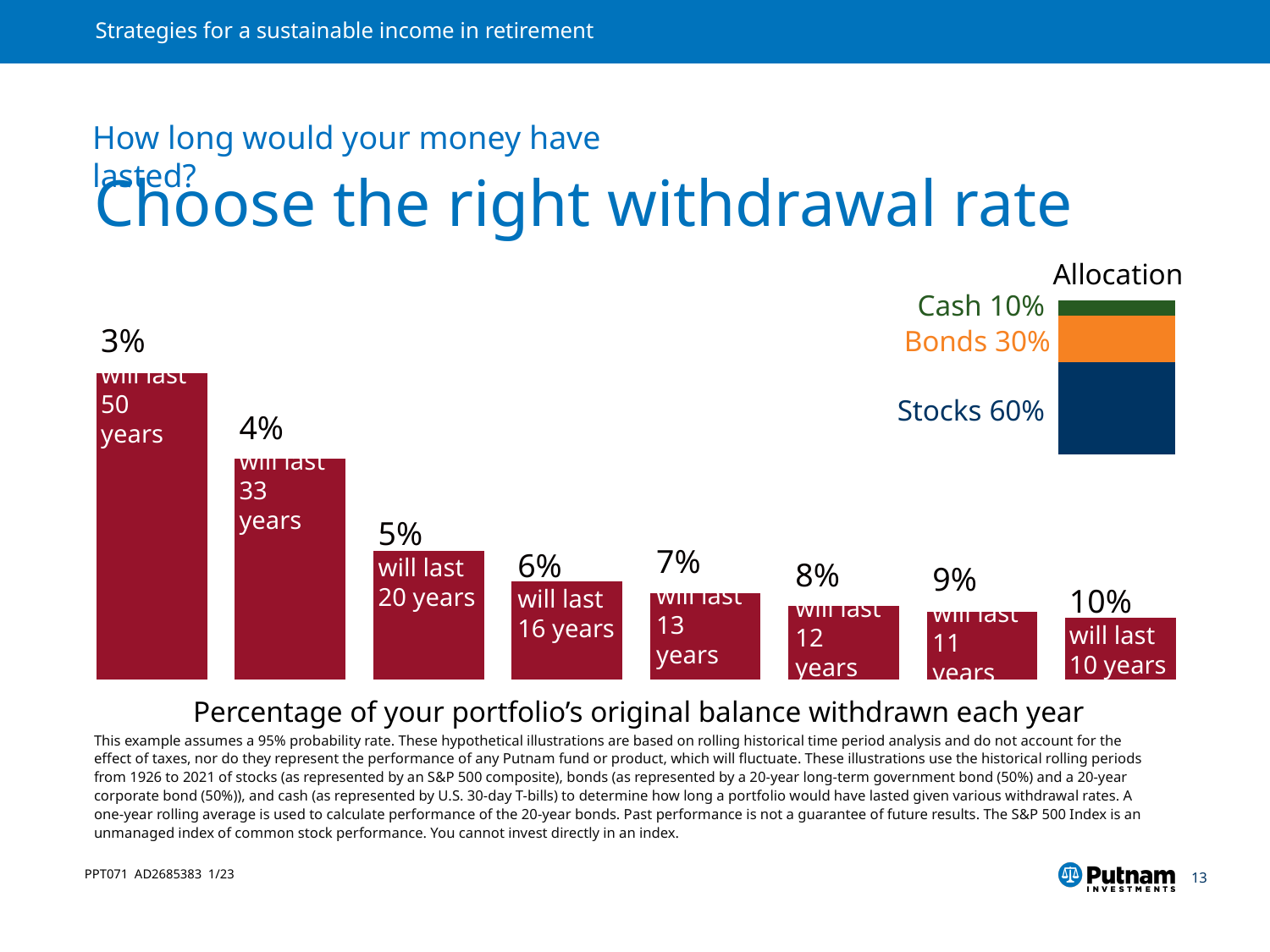
What kind of chart is used to show how long the money would have lasted at each withdrawal rate? Bar chart In the bar chart on the left, which withdrawal rate has the tallest bar (lasts the longest)? 3% In the bar chart on the left, how many withdrawal rates are shown? 8 In the bar chart on the left, which withdrawal rate has the shortest bar (lasts the fewest years)? 10% In the bar chart on the left, how many years will the money last at a 10% withdrawal rate? 10 years In the bar chart on the left, how many more years does the money last at a 4% withdrawal rate than at a 5% withdrawal rate? 13 years In the bar chart on the left, how many years will the money last at a 5% withdrawal rate? 20 years In the bar chart on the left, do the bars rise or fall as the withdrawal rate increases from 3% to 10%? Fall In the bar chart on the left, how many years will the money last at a 3% withdrawal rate? 50 years In the Allocation chart on the right, what is the combined share of Cash and Bonds? 40% In the bar chart on the left, which lasts longer: a 6% withdrawal rate or an 8% withdrawal rate? 6% In the Allocation chart on the right, what percentage is allocated to Stocks? 60%